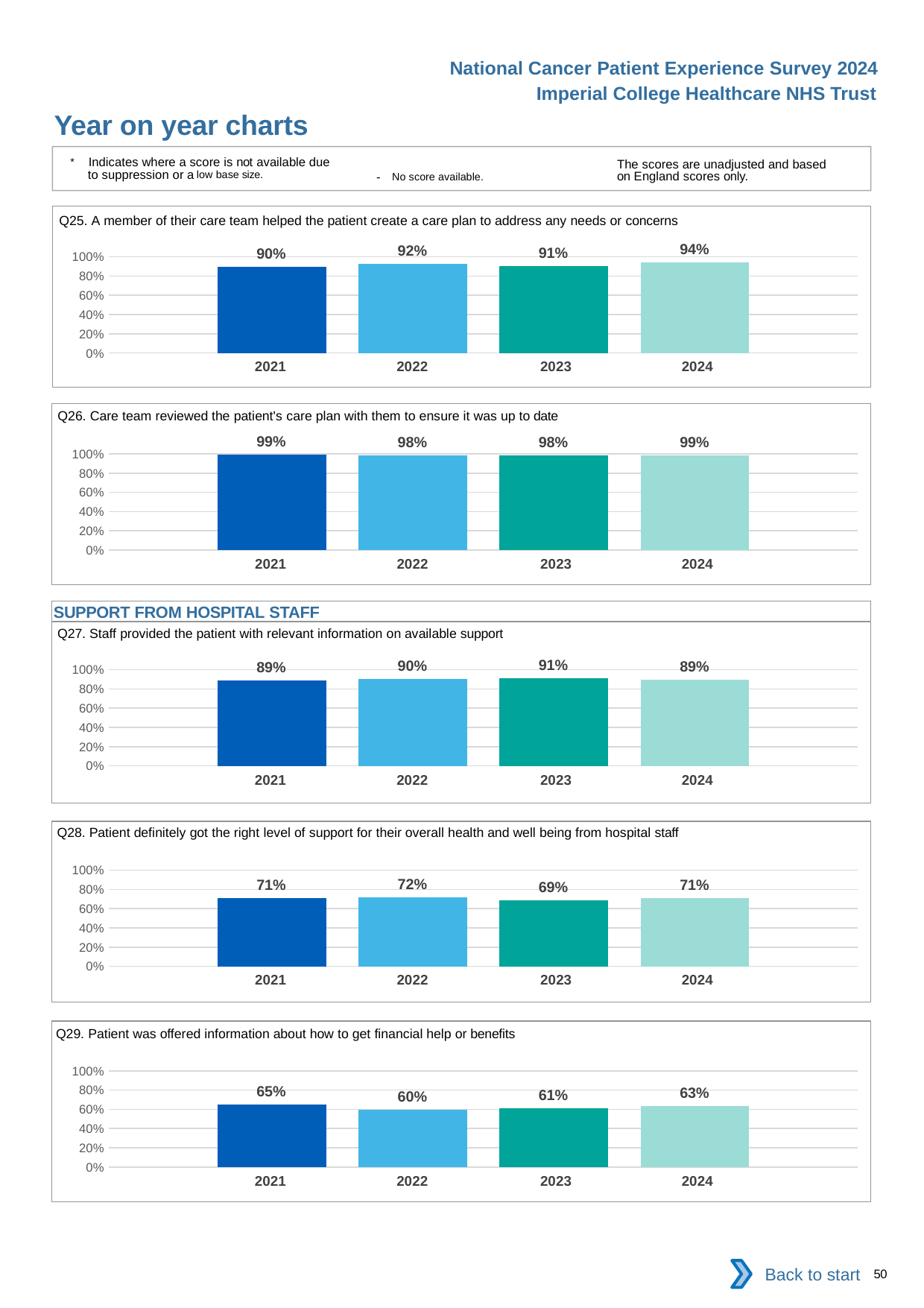
In the Q27 chart (relevant information on available support), which year has the highest value? 2023 In the Q26 chart (care team reviewed the care plan), how many years are shown on the x axis? 4 In the Q29 chart (information about financial help or benefits), what is the difference between the 2021 and 2022 values? 5 percentage points In the Q28 chart (right level of support from hospital staff), is the value for 2022 greater or less than 80%? less What type of chart is used for Q28 (right level of support from hospital staff)? Bar chart In the Q26 chart (care team reviewed the care plan), what is the value for 2022? 98% In the Q25 chart (care plan to address needs or concerns), which year has the lowest value? 2021 In the Q25 chart (care plan to address needs or concerns), what is the value for 2024? 94% In the Q27 chart (relevant information on available support), what is the difference between the 2023 and 2024 values? 2 percentage points In the Q28 chart (right level of support from hospital staff), what is the value for 2023? 69% In the Q29 chart (information about financial help or benefits), which year has the highest value? 2021 In the Q29 chart (information about financial help or benefits), which is larger, the value for 2022 or the value for 2024? 2024